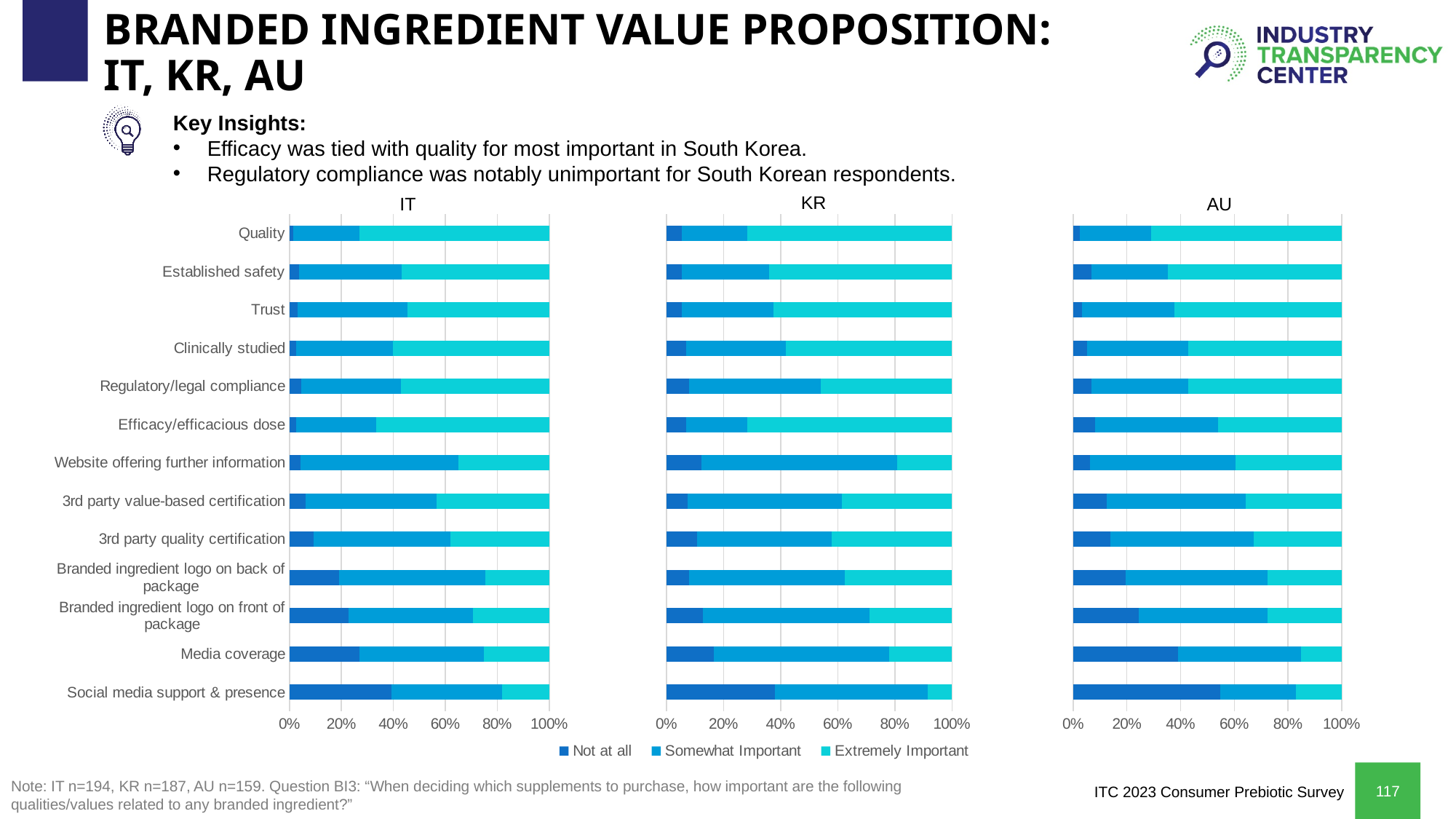
In the IT chart, which category has the smallest 'Not at all' segment? Quality What kind of chart is used for the IT, KR and AU panels on this slide? Stacked bar chart In the KR chart, which has the larger 'Not at all' segment: Regulatory/legal compliance or Media coverage? Media coverage What are the three series named in the legend? Not at all, Somewhat Important, Extremely Important What are the titles of the three charts, from left to right? IT, KR, AU In the AU chart, is the 'Not at all' value for Social media support & presence greater or less than 40%? greater In the IT chart, is the 'Not at all' value for Social media support & presence greater or less than 20%? greater In the KR chart, is the 'Not at all' value for Media coverage greater or less than 20%? less In the IT chart, what do the three segments of the Quality bar add up to? 100% How many series does the legend list for these charts? 3 In the AU chart, which category has the largest 'Not at all' segment? Social media support & presence How many categories are listed on the vertical axis of the IT chart? 13